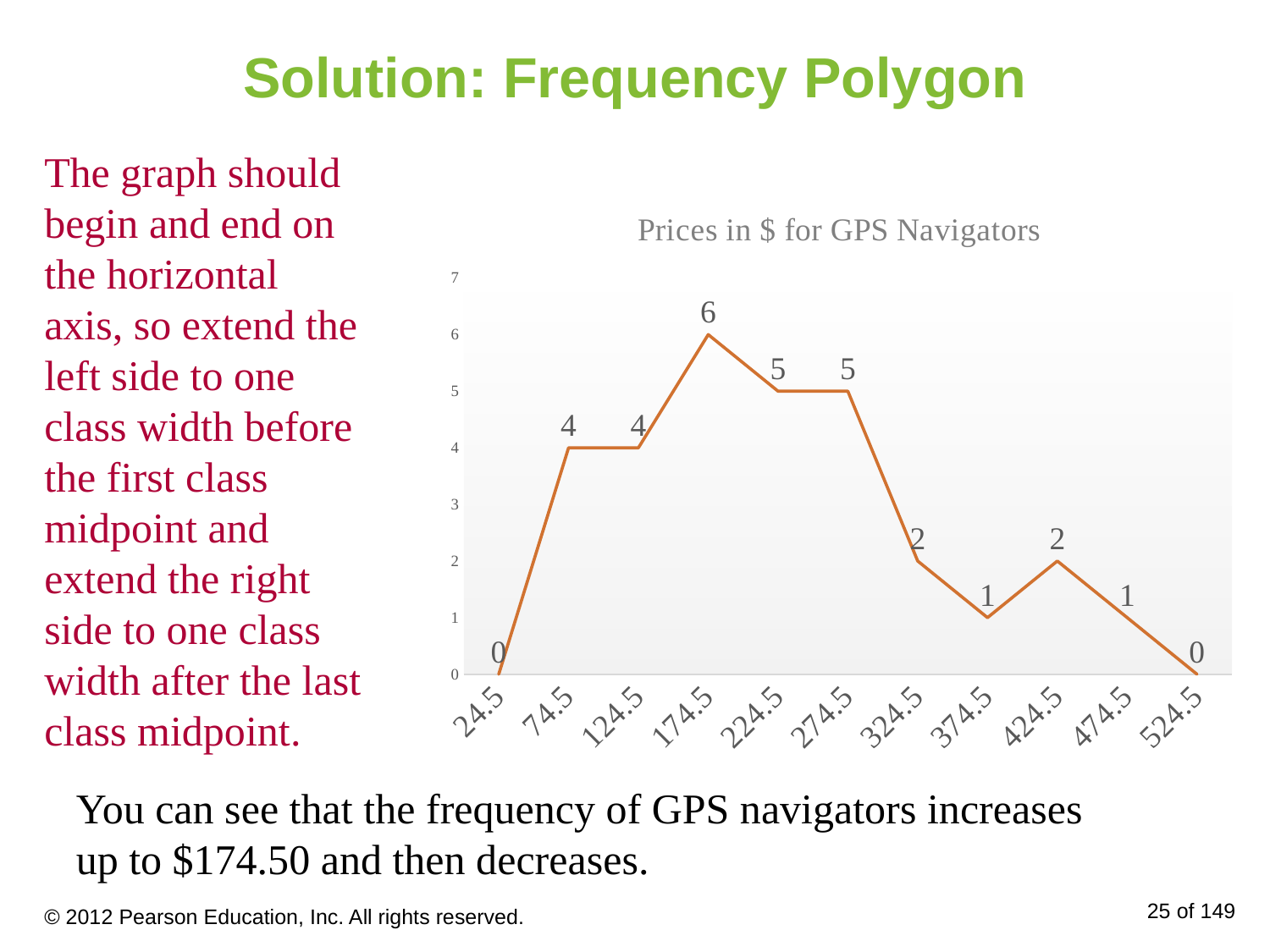
What is the frequency at the midpoint 524.5? 0 What kind of chart is shown on the slide? Line chart Which midpoint has the highest frequency? 174.5 Does the frequency rise or fall between 274.5 and 374.5? Fall What is the difference between the frequencies at 174.5 and 374.5? 5 What is the frequency at the midpoint 324.5? 2 How many points are plotted on the frequency polygon? 11 What is the frequency at the midpoint 174.5? 6 What is the difference between the frequencies at 74.5 and 324.5? 2 What is the frequency at the midpoint 74.5? 4 Which has a higher frequency, 224.5 or 424.5? 224.5 What is the title of the chart? Prices in $ for GPS Navigators